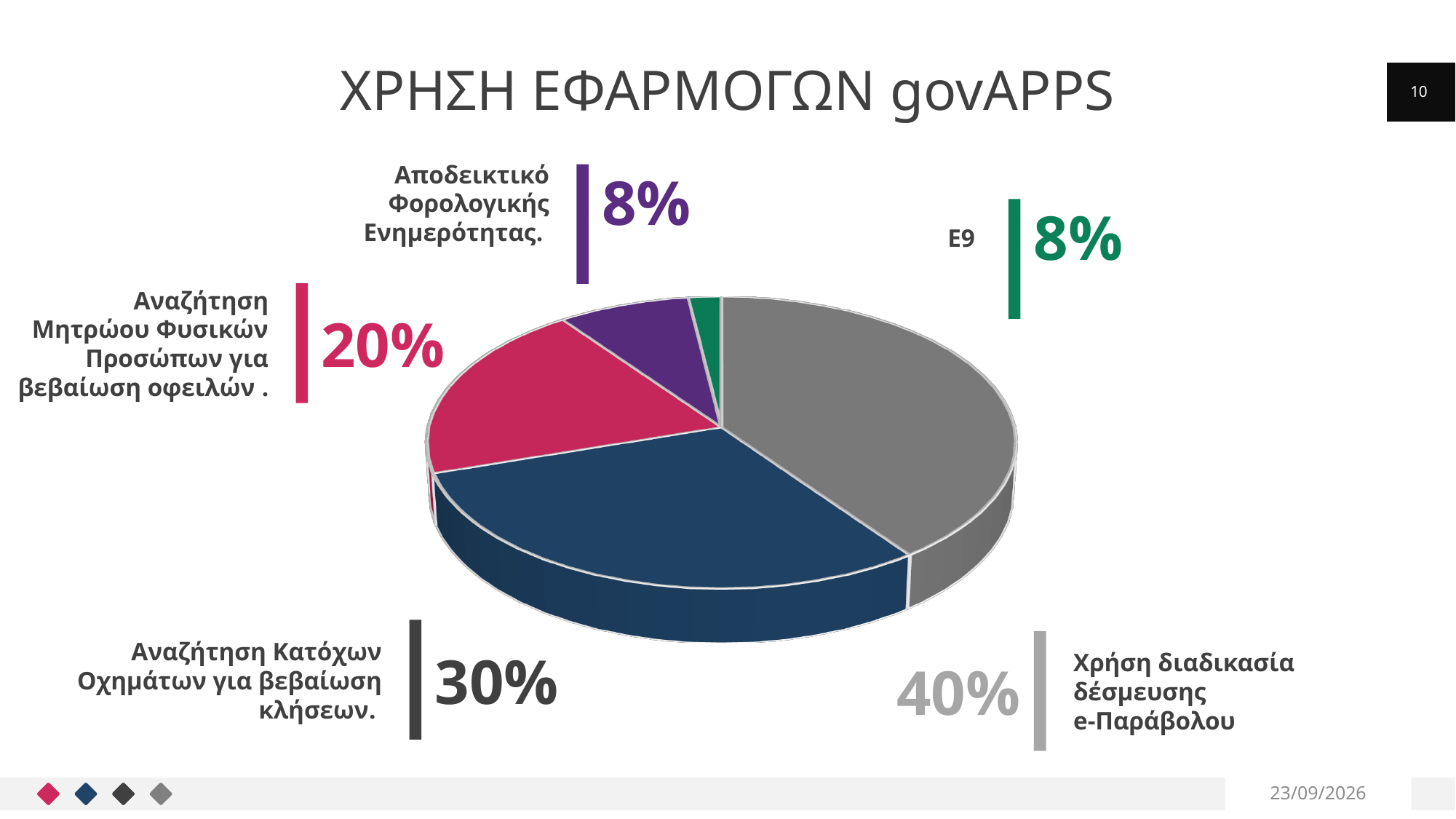
What is the difference in percentage points between Χρήση διαδικασία δέσμευσης e-Παραβόλου and Αναζήτηση Κατόχων Οχημάτων για βεβαίωση κλήσεων? 10% What percentage is shown for Χρήση διαδικασία δέσμευσης e-Παραβόλου? 40% Which is larger: the share for Αναζήτηση Μητρώου Φυσικών Προσώπων για βεβαίωση οφειλών or the share for Ε9? Αναζήτηση Μητρώου Φυσικών Προσώπων για βεβαίωση οφειλών What colour is the slice for Αναζήτηση Κατόχων Οχημάτων για βεβαίωση κλήσεων? Dark blue Which category has the largest share of the pie? Χρήση διαδικασία δέσμευσης e-Παραβόλου What percentage is shown for Αποδεικτικό Φορολογικής Ενημερότητας? 8% What percentage is shown for Ε9? 8% How many slices does the pie chart have? 5 What kind of chart is shown on the slide? Pie chart What percentage is shown for Αναζήτηση Μητρώου Φυσικών Προσώπων για βεβαίωση οφειλών? 20% What is the title of the chart on the slide? ΧΡΗΣΗ ΕΦΑΡΜΟΓΩΝ govAPPS What percentage is shown for Αναζήτηση Κατόχων Οχημάτων για βεβαίωση κλήσεων? 30%